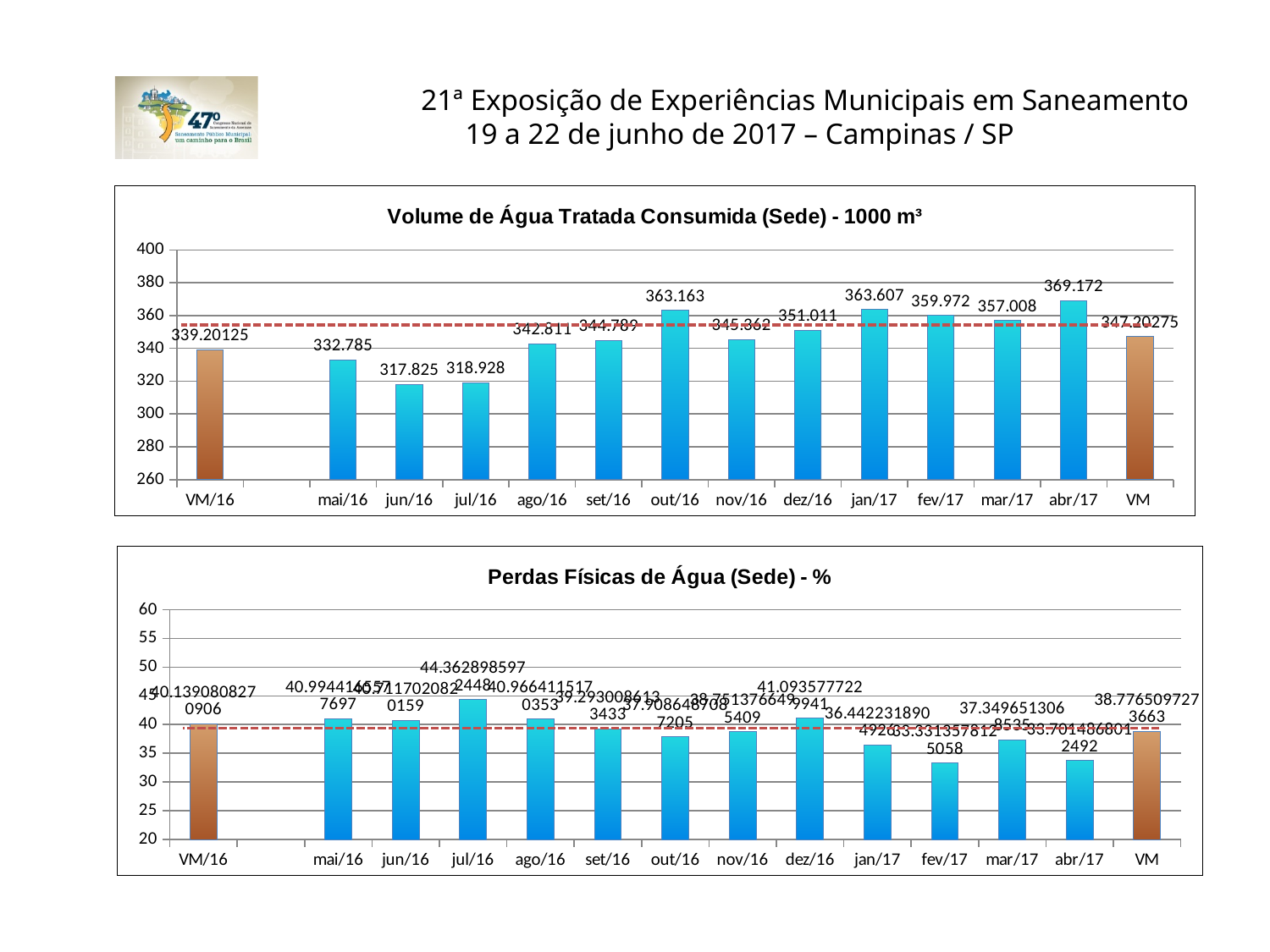
In the bottom chart, Perdas Físicas de Água (Sede), which category has the highest value? jul/16 In the top chart, Volume de Água Tratada Consumida (Sede), which category has the lowest value? jun/16 How many bars are plotted in the top chart, Volume de Água Tratada Consumida (Sede)? 14 In the top chart, Volume de Água Tratada Consumida (Sede), what is the difference between the values for abr/17 and jun/16? 51.347 What kind of chart is the bottom chart, Perdas Físicas de Água (Sede)? Bar chart What is the title of the bottom chart on the slide? Perdas Físicas de Água (Sede) - % In the top chart, Volume de Água Tratada Consumida (Sede), what is the value for VM/16? 339.20125 In the top chart, Volume de Água Tratada Consumida (Sede), what is the value for jun/16? 317.825 In the bottom chart, Perdas Físicas de Água (Sede), is the value for fev/17 greater or less than 35? less In the top chart, Volume de Água Tratada Consumida (Sede), which is larger, the value for mai/16 or the value for ago/16? ago/16 In the top chart, Volume de Água Tratada Consumida (Sede), which category has the highest value? abr/17 In the top chart, Volume de Água Tratada Consumida (Sede), what is the value for abr/17? 369.172